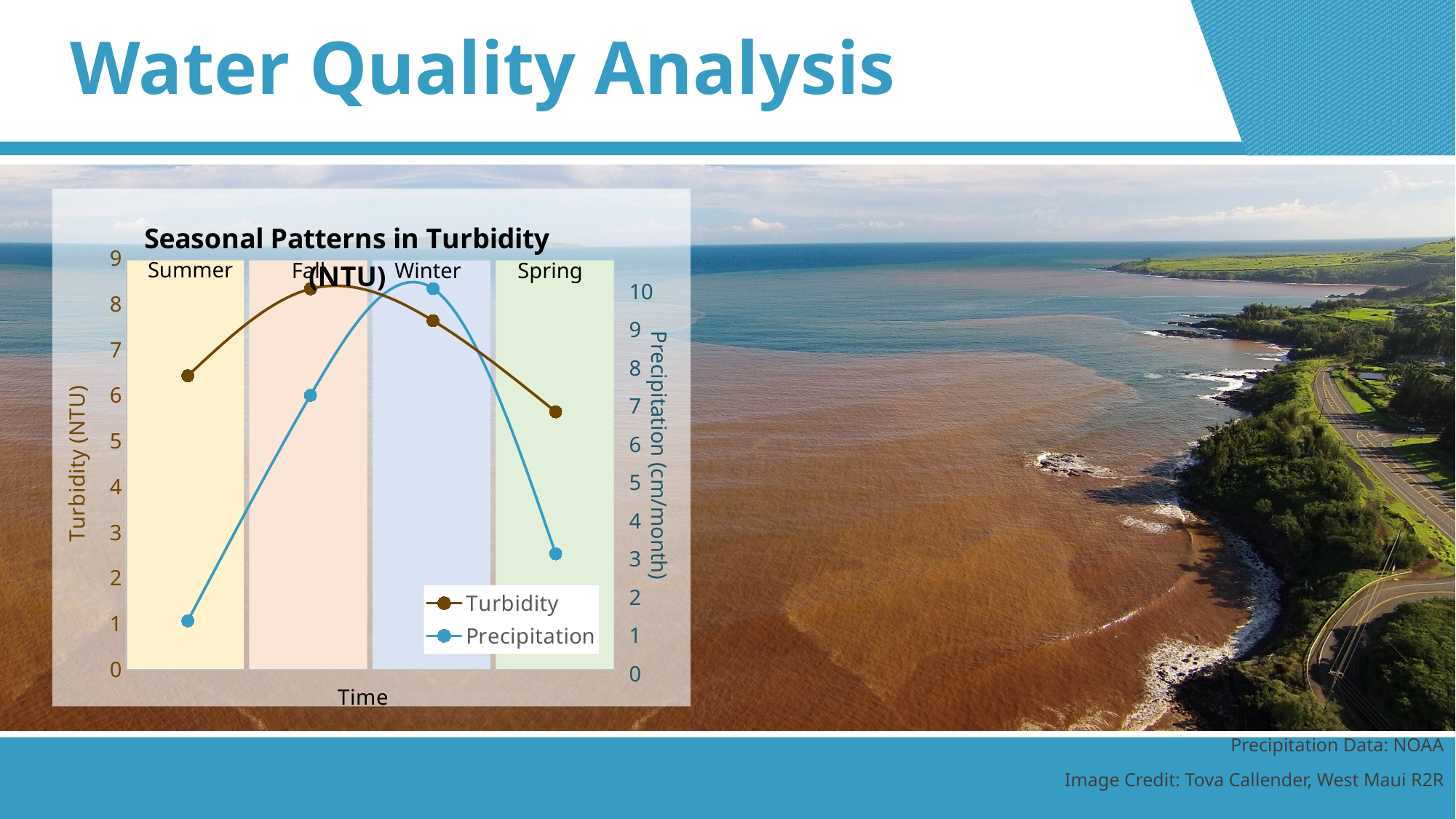
How many seasons are plotted along the x axis of the chart? 4 Which season has higher Precipitation, Fall or Spring? Fall What kind of chart is shown on the slide? Line chart In which season is Turbidity lowest? Spring In which season is Precipitation highest? Winter How does Precipitation change from Summer to Winter? It rises How many series does the legend list in the Seasonal Patterns in Turbidity chart? 2 In which season is Turbidity highest? Fall What is the label of the right-hand vertical axis? Precipitation (cm/month) Is the Turbidity value for Summer greater or less than 6? greater Is the Precipitation value for Spring greater or less than 4? less In which season is Precipitation lowest? Summer